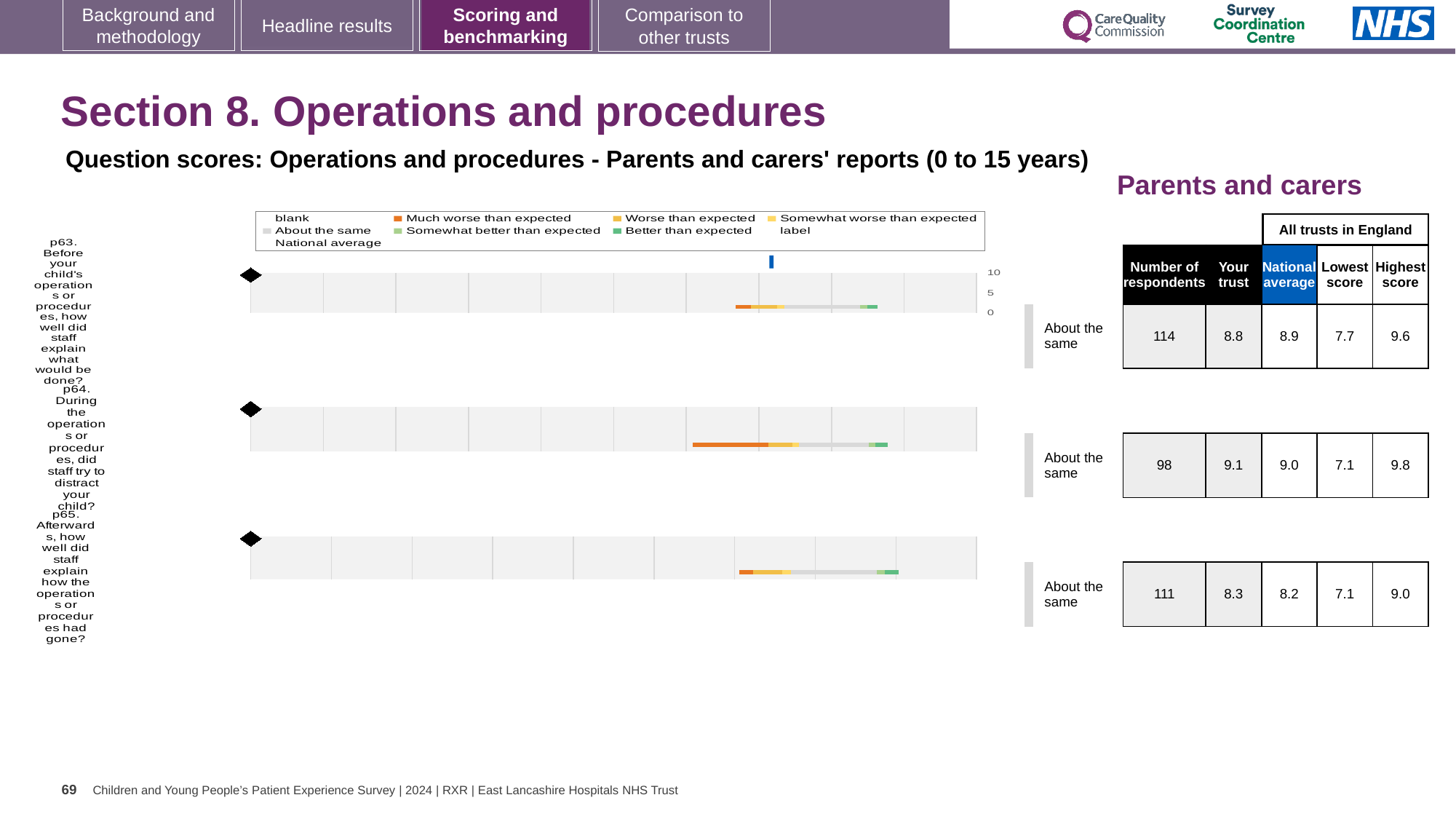
How many respondents answered question p65 (Afterwards, how well did staff explain how the operations or procedures had gone?)? 111 What benchmark category is shown for question p65? About the same What kind of chart is used to show the question scores? bar chart What is the 'Your trust' score for question p64 (During the operations or procedures, did staff try to distract your child?)? 9.1 Which question has the largest number of respondents? p63 How many survey questions are plotted on the chart? 3 Which question has the highest 'Your trust' score? p64 What is the difference between the highest score and the lowest score for question p64? 2.7 For question p63, is the 'Your trust' score higher or lower than the national average? lower Which question has the lowest 'Your trust' score? p65 What is the highest score among all trusts in England for question p63? 9.6 What is the national average score for question p63 (Before your child's operations or procedures, how well did staff explain what would be done?)? 8.9